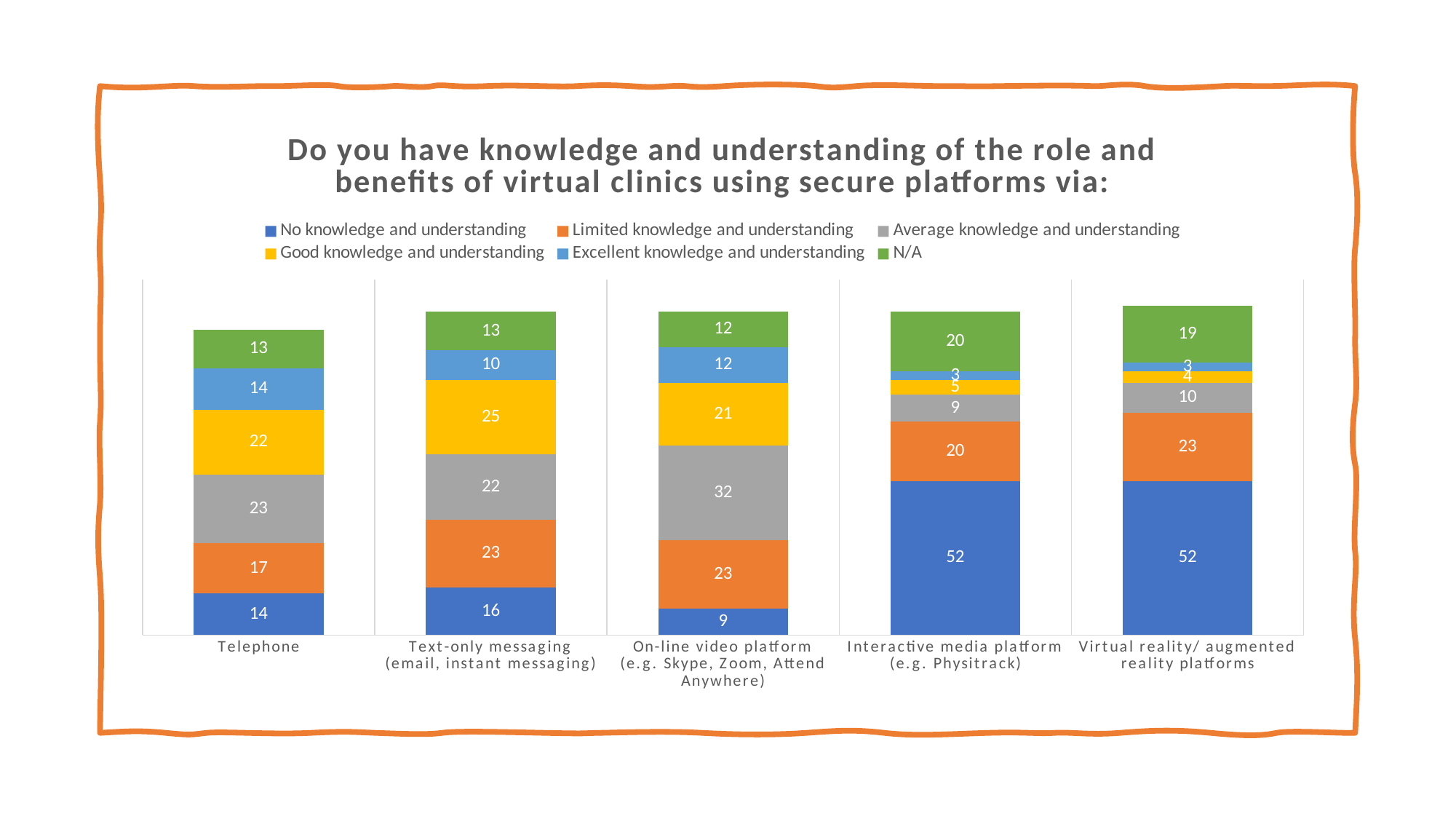
What is the value for 'Good knowledge and understanding' for the Text-only messaging category? 25 How many categories are shown on the x axis? 5 Which category has the lowest value for 'No knowledge and understanding'? On-line video platform (e.g. Skype, Zoom, Attend Anywhere) Which has the larger N/A value: Interactive media platform or Telephone? Interactive media platform (e.g. Physitrack) For the Telephone category, what is the difference between the 'Average knowledge and understanding' value and the 'No knowledge and understanding' value? 9 What is the total of the stacked bar for the Telephone category? 103 How many series does the legend list? 6 What is the value for 'Average knowledge and understanding' for the On-line video platform category? 32 What is the N/A value for the Virtual reality/ augmented reality platforms category? 19 Which category has the highest value for 'Average knowledge and understanding'? On-line video platform (e.g. Skype, Zoom, Attend Anywhere) What kind of chart is shown on the slide? Stacked bar chart What is the value for 'No knowledge and understanding' for the Interactive media platform (e.g. Physitrack) category? 52